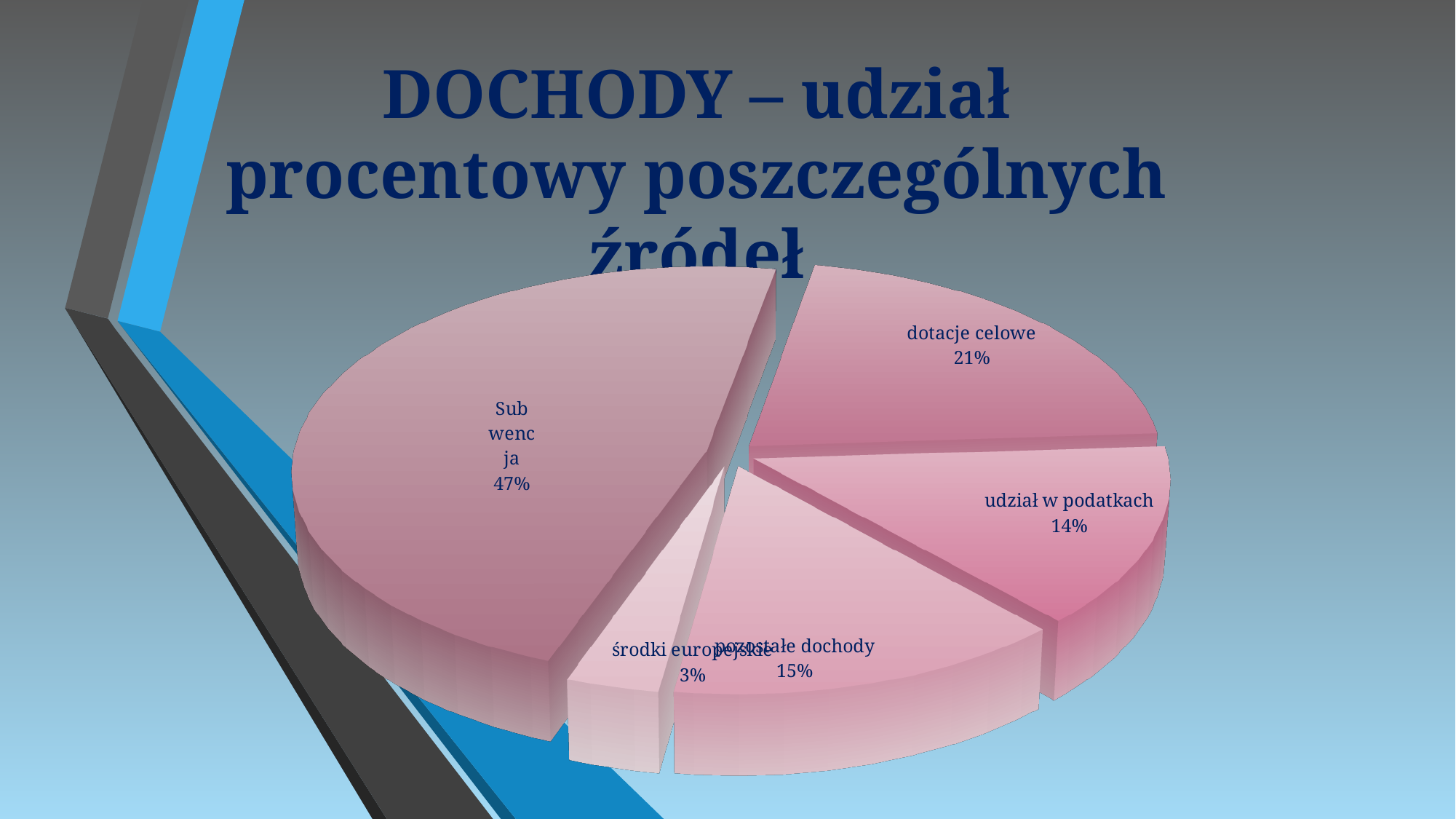
What is the difference in percentage points between "Subwencja" and "dotacje celowe"? 26 What kind of chart is shown on the slide? pie chart Which slice of the pie is the smallest? środki europejskie What share of the pie does "środki europejskie" have? 3% What share of the pie does "Subwencja" have? 47% What share of the pie does "dotacje celowe" have? 21% What is the title of the chart on the slide? DOCHODY – udział procentowy poszczególnych źródeł How many slices does the pie chart have? 5 Which slice of the pie is the largest? Subwencja